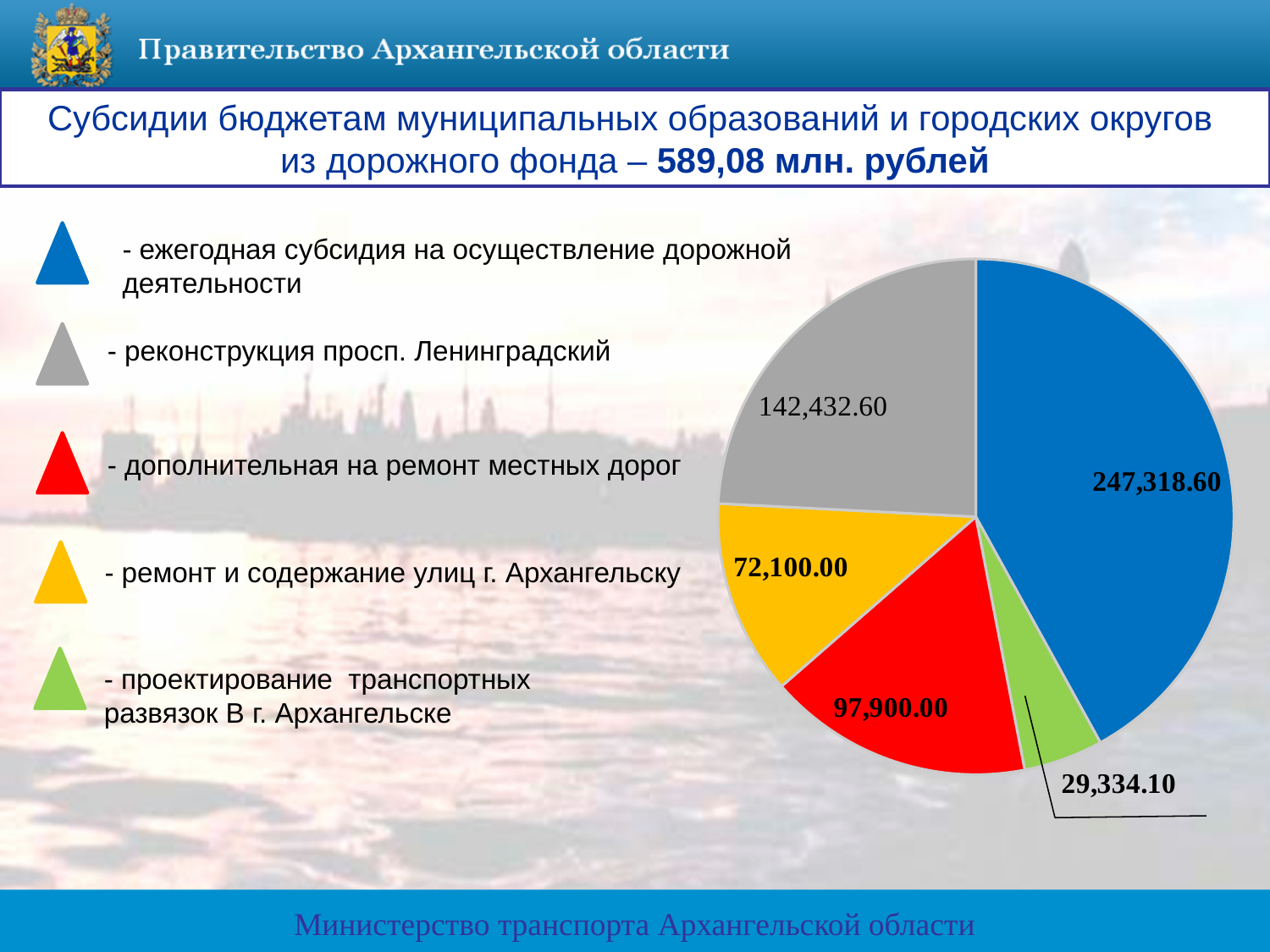
What kind of chart is shown on the slide? pie chart Which category has the smallest slice of the pie? проектирование транспортных развязок в г. Архангельске Which category has the largest slice of the pie? ежегодная субсидия на осуществление дорожной деятельности What is the value of the blue slice (ежегодная субсидия на осуществление дорожной деятельности)? 247,318.60 What is the value of the gray slice (реконструкция просп. Ленинградский)? 142,432.60 What is the difference between the blue slice (247,318.60) and the gray slice (142,432.60)? 104,886.00 Which is larger: the red slice (дополнительная на ремонт местных дорог) or the yellow slice (ремонт и содержание улиц г. Архангельску)? дополнительная на ремонт местных дорог What is the value of the red slice (дополнительная на ремонт местных дорог)? 97,900.00 What is the value of the green slice (проектирование транспортных развязок в г. Архангельске)? 29,334.10 What is the value of the yellow slice (ремонт и содержание улиц г. Архангельску)? 72,100.00 How many slices does the pie chart have? 5 What colour is the slice for реконструкция просп. Ленинградский? gray